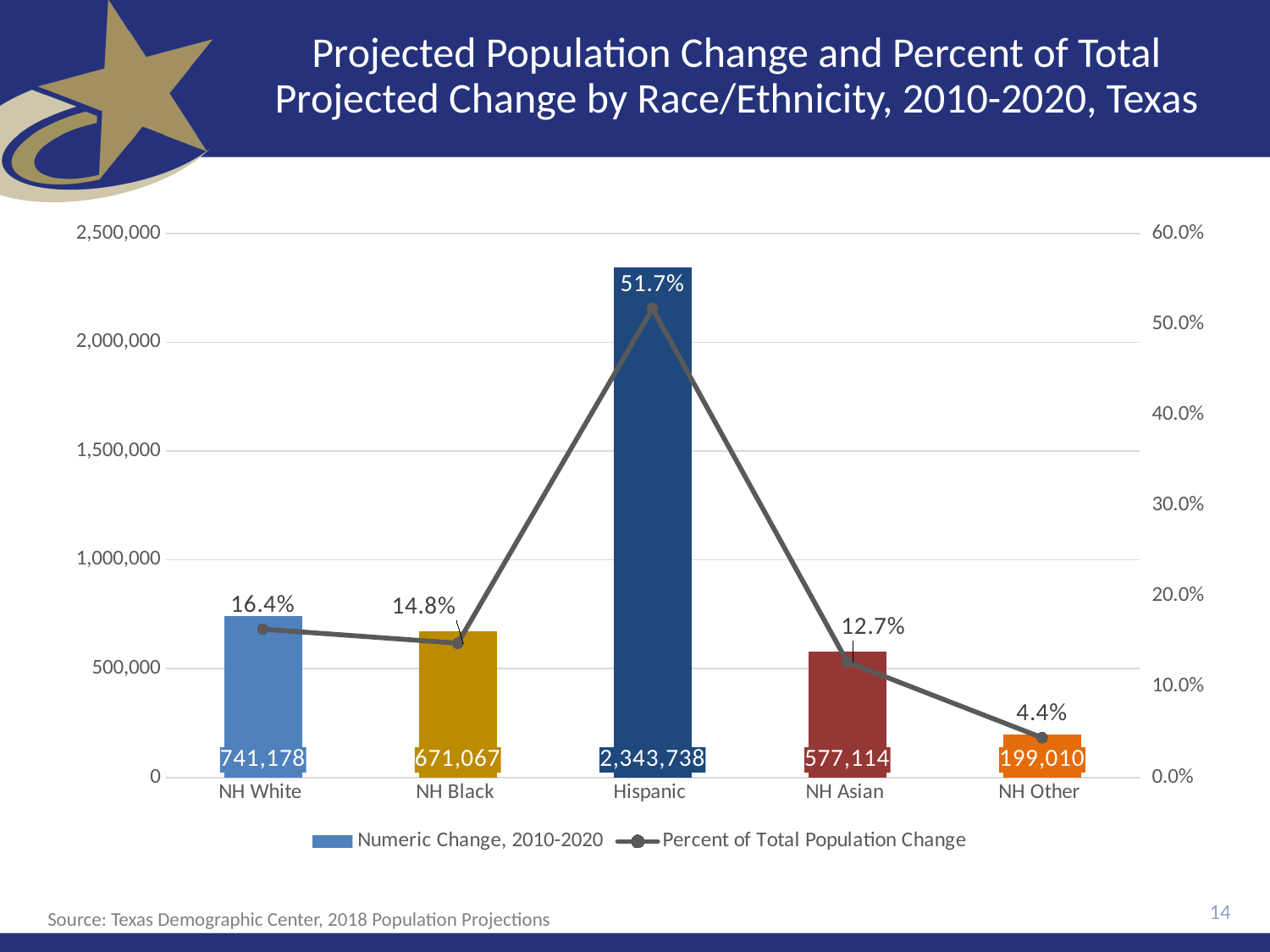
What is the difference in Numeric Change, 2010-2020 between NH White and NH Black? 70,111 Which has a larger Numeric Change, 2010-2020: NH Black or NH Asian? NH Black What is the Numeric Change, 2010-2020 for Hispanic? 2,343,738 What is the Numeric Change, 2010-2020 for NH Other? 199,010 What is the source cited at the bottom of the slide? Texas Demographic Center, 2018 Population Projections What kind of chart is used to show the Numeric Change, 2010-2020 series? Bar chart Is the Numeric Change, 2010-2020 for NH White greater or less than 500,000? greater Which race/ethnicity category has the highest Numeric Change, 2010-2020? Hispanic How many race/ethnicity categories are shown on the x axis? 5 What is the Percent of Total Population Change for NH Asian? 12.7% How many series does the legend list? 2 Which race/ethnicity category has the lowest Percent of Total Population Change? NH Other